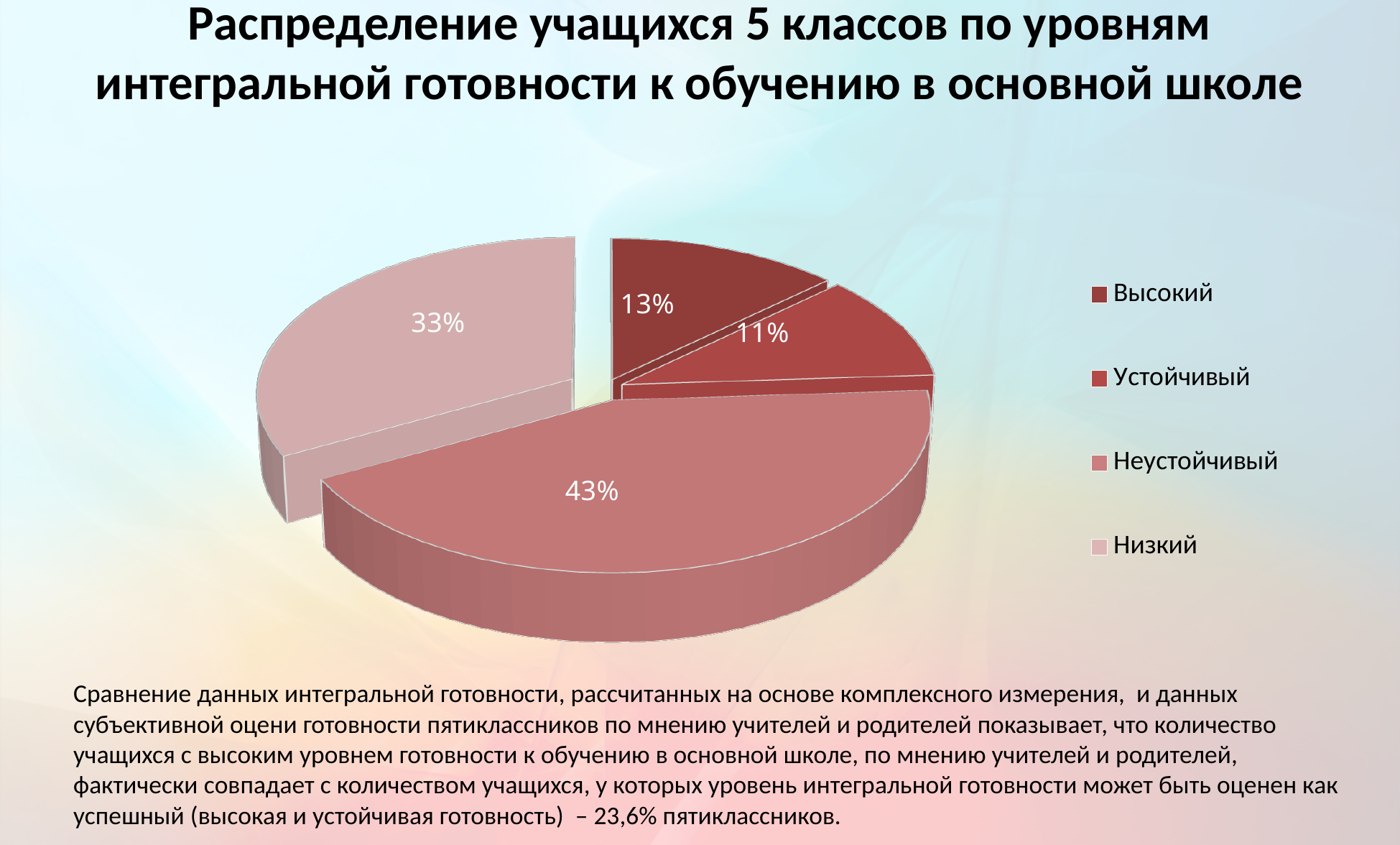
What percentage of students are in the "Высокий" category? 13% What percentage of students are in the "Устойчивый" category? 11% What percentage of students are in the "Неустойчивый" category? 43% What kind of chart is shown on the slide? Pie chart How many entries does the legend list? 4 Which category has a larger share: "Высокий" or "Низкий"? Низкий Which category has the largest share of the pie? Неустойчивый What is the difference in percentage points between the "Неустойчивый" and "Низкий" categories? 10 How many categories does the pie chart show? 4 What percentage of students are in the "Низкий" category? 33% Which category has the smallest share of the pie? Устойчивый Which legend entry is shown in the lightest pink colour? Низкий